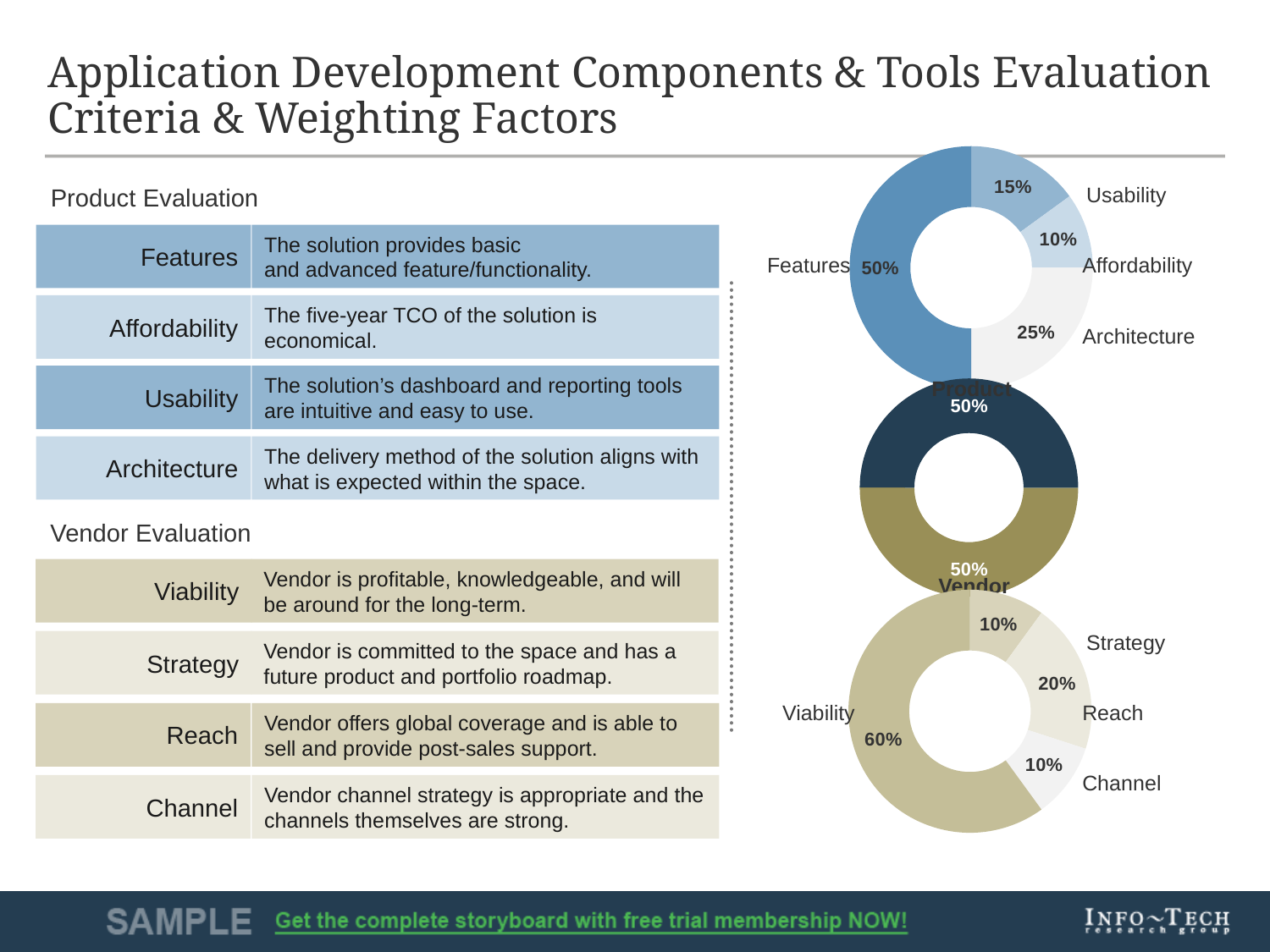
What type of chart is used on the right side of the slide? Donut chart In the middle donut chart, what percentage is shown for Vendor? 50% In the bottom donut chart, what is the difference between the Viability share and the Reach share? 40% In the bottom donut chart, what percentage is shown for Viability? 60% In the top donut chart, what is the difference between the Features share and the Usability share? 35% In the bottom donut chart, which is larger, the share for Reach or the share for Channel? Reach In the bottom donut chart, which category has the largest share? Viability In the top donut chart, what percentage is shown for Features? 50% In the top donut chart, what percentage is shown for Architecture? 25% In the top donut chart, how many categories are shown? 4 In the bottom donut chart, what percentage is shown for Reach? 20% In the top donut chart, which category has the smallest share? Affordability